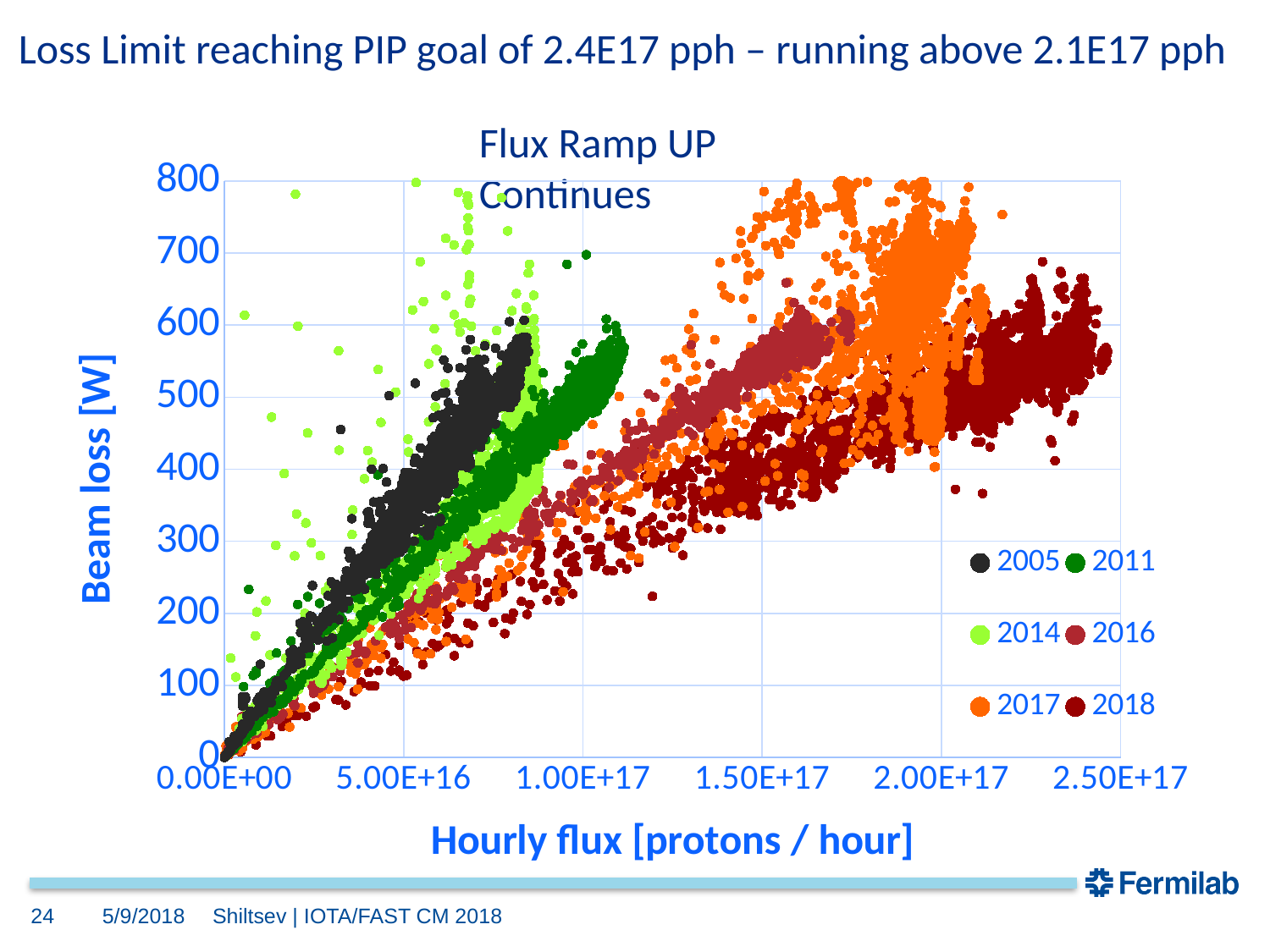
Which series reaches higher hourly flux values, 2005 or 2017? 2017 How many series does the legend list? 6 Is the maximum hourly flux reached by the 2005 series greater or less than 1.00E+17? less Which series extends to the highest hourly flux values on the x axis? 2018 Which years are listed in the chart legend? 2005, 2011, 2014, 2016, 2017, 2018 Does beam loss generally rise or fall as hourly flux increases along the x axis? rise What is the highest tick value shown on the beam loss axis? 800 Is the maximum hourly flux reached by the 2018 series greater or less than 2.00E+17? greater What kind of chart is shown on the slide? scatter chart Is the maximum hourly flux reached by the 2011 series greater or less than 1.50E+17? less What is the label of the vertical axis? Beam loss [W]